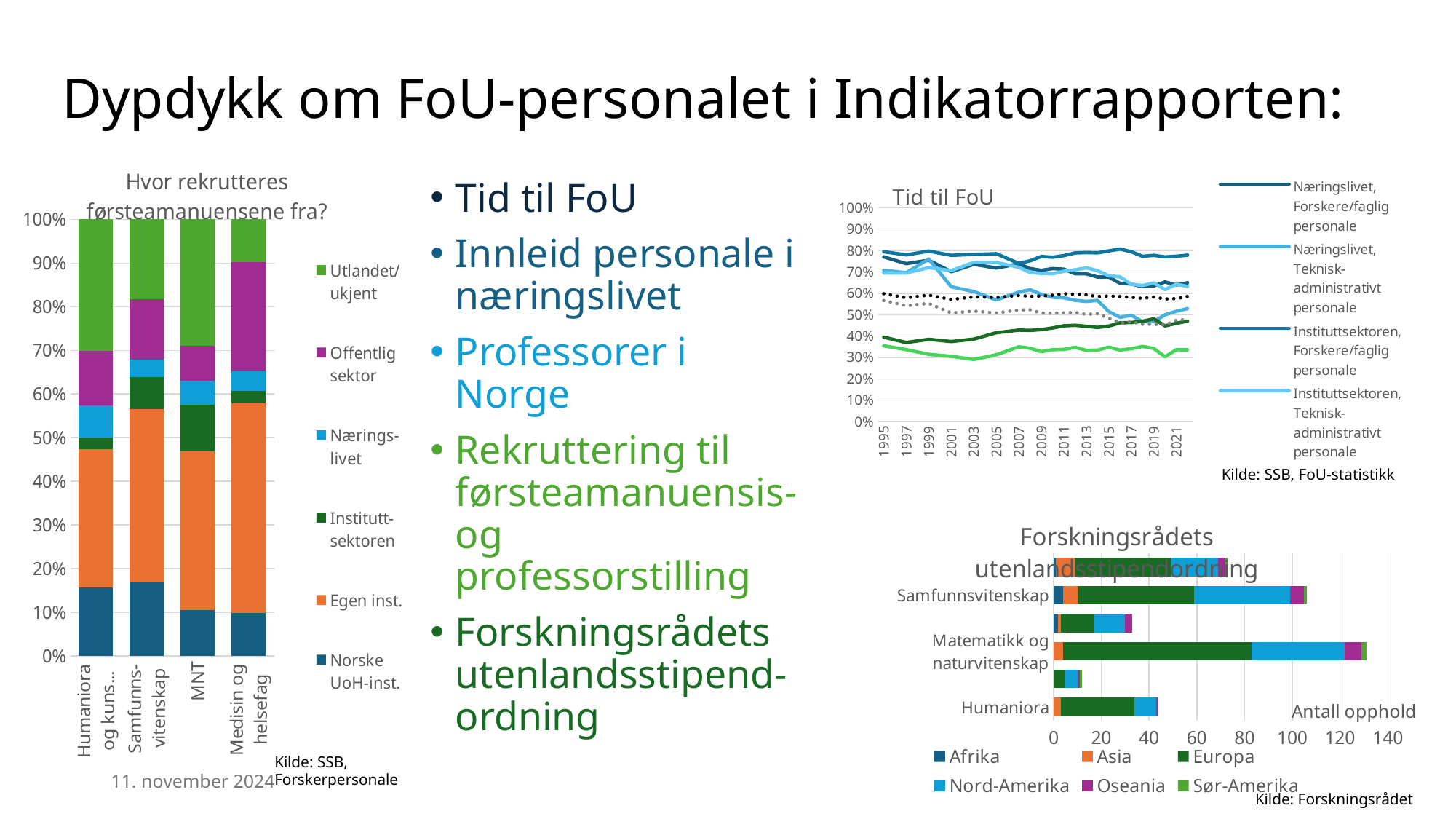
How many series does the legend of 'Forskningsrådets utenlandsstipendordning' list? 6 In 'Hvor rekrutteres førsteamanuensene fra?', which category has the largest Egen inst. share? Medisin og helsefag In 'Hvor rekrutteres førsteamanuensene fra?', is the Norske UoH-inst. share for Medisin og helsefag greater or less than 20%? less How many series does the legend of 'Hvor rekrutteres førsteamanuensene fra?' list? 6 In 'Forskningsrådets utenlandsstipendordning', is the total number of opphold for Matematikk og naturvitenskap greater or less than 120? greater In 'Hvor rekrutteres førsteamanuensene fra?', is the Norske UoH-inst. share for Samfunnsvitenskap greater or less than 10%? greater In 'Hvor rekrutteres førsteamanuensene fra?', which category has the largest Offentlig sektor share? Medisin og helsefag What is the first year shown on the x axis of 'Tid til FoU'? 1995 What kind of chart is 'Hvor rekrutteres førsteamanuensene fra?'? Stacked bar chart What kind of chart is 'Tid til FoU'? Line chart What kind of chart is 'Forskningsrådets utenlandsstipendordning'? Stacked bar chart In 'Hvor rekrutteres førsteamanuensene fra?', how many categories are shown on the x axis? 4